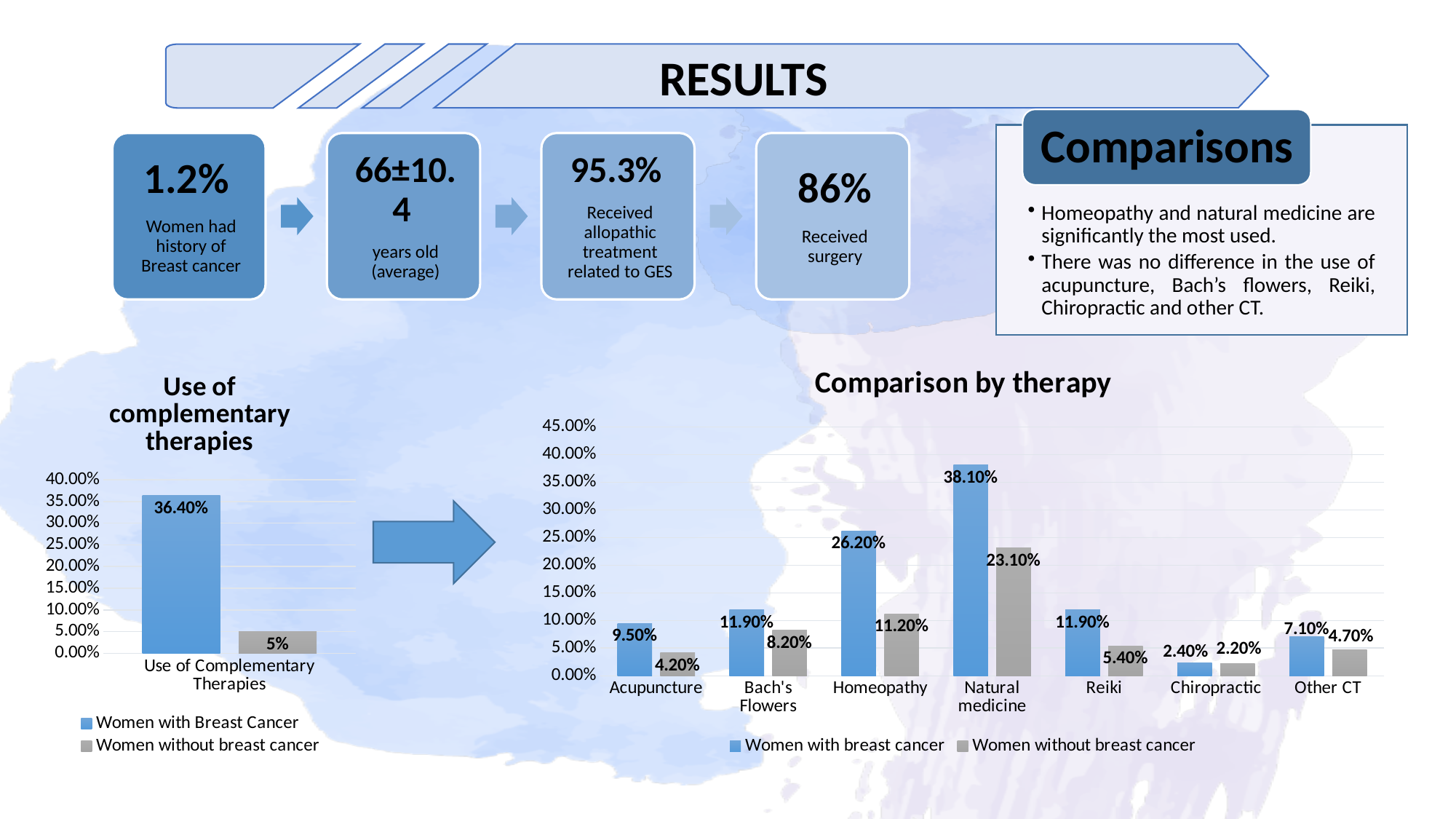
In the 'Comparison by therapy' chart, which therapy has the lowest value for Women without breast cancer? Chiropractic In the 'Comparison by therapy' chart, which therapy has the highest value for Women with breast cancer? Natural medicine In the 'Use of complementary therapies' chart, what is the difference between Women with Breast Cancer and Women without breast cancer? 31.40% How many therapy categories are shown in the 'Comparison by therapy' chart? 7 In the 'Comparison by therapy' chart, what colour are the bars for Women without breast cancer? Grey How many series does the legend of the 'Comparison by therapy' chart list? 2 In the 'Comparison by therapy' chart, what is the value for Women without breast cancer for Homeopathy? 11.20% In the 'Use of complementary therapies' chart, what is the value for Women with Breast Cancer? 36.40% In the 'Comparison by therapy' chart, what is the difference between Women with breast cancer and Women without breast cancer for Homeopathy? 15.00% In the 'Comparison by therapy' chart, what is the value for Women with breast cancer for Natural medicine? 38.10% In the 'Comparison by therapy' chart, which is larger for Reiki: Women with breast cancer or Women without breast cancer? Women with breast cancer What kind of chart is the 'Use of complementary therapies' chart? Bar chart